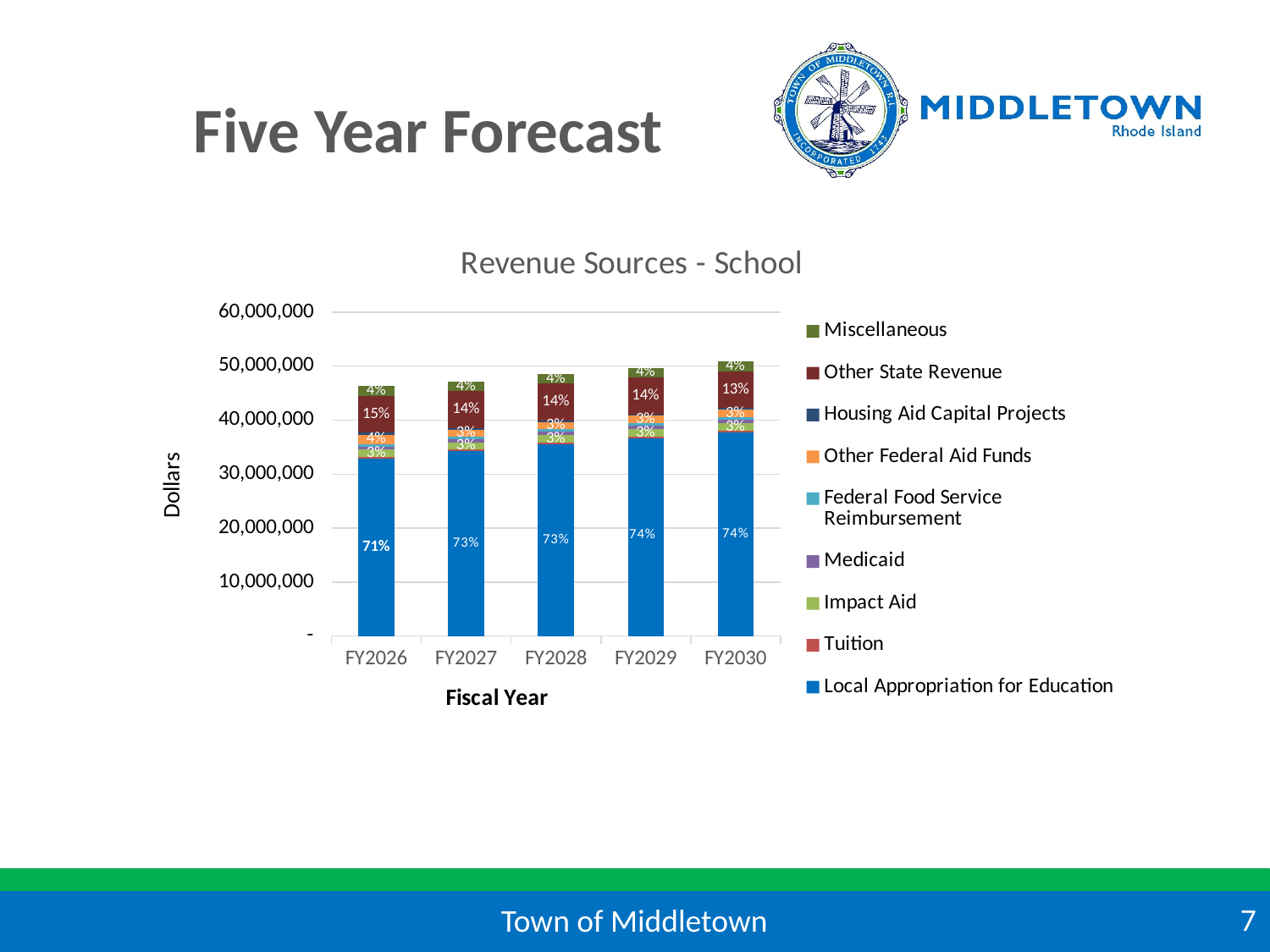
Is the total revenue bar for FY2026 greater or less than 50,000,000? less How many fiscal years are shown on the x axis? 5 What type of chart is shown on the slide? Stacked bar chart What percentage of FY2029 revenue is Miscellaneous? 4% Do the total revenue bars rise or fall from FY2026 to FY2030? rise Which is larger, the Local Appropriation for Education percentage in FY2026 or in FY2030? FY2030 What is the title of the chart? Revenue Sources - School What percentage of FY2026 revenue is Local Appropriation for Education? 71% How many series does the legend list? 9 Which fiscal year has the highest percentage for Other State Revenue? FY2026 What percentage of FY2030 revenue is Other State Revenue? 13% By how many percentage points does the Other State Revenue share in FY2026 exceed that in FY2030? 2 percentage points